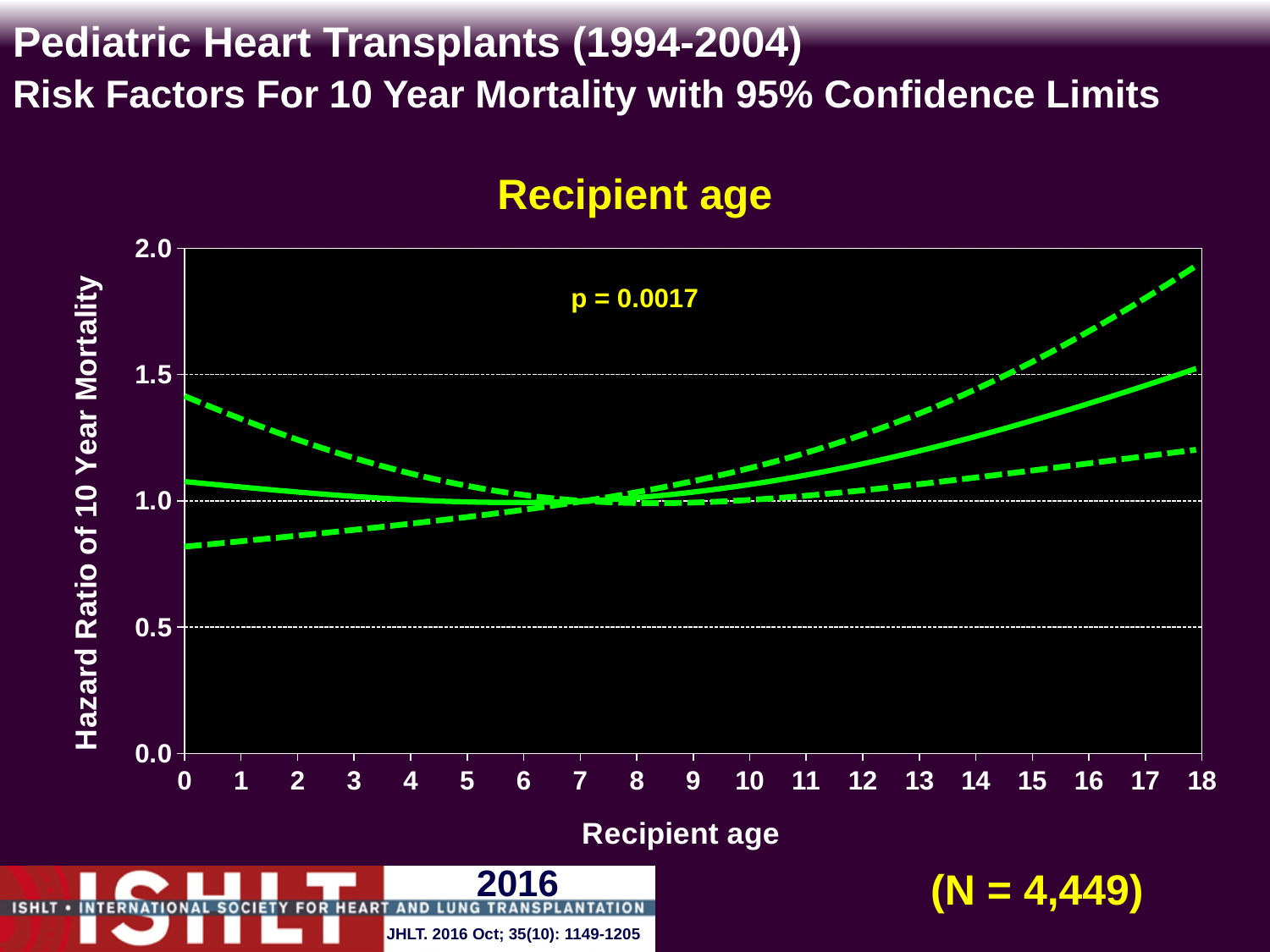
What is the p-value printed on the chart? p = 0.0017 Is the value of the solid hazard ratio line at recipient age 18 greater or less than 1.0? greater What is the title of the chart? Recipient age What is the highest recipient age shown on the x axis? 18 Is the value of the upper dashed confidence limit at recipient age 18 greater or less than 1.5? greater What is the sample size (N) shown on the slide? 4,449 Is the value of the lower dashed confidence limit at recipient age 0 greater or less than 1.0? less How many lines are plotted on the chart? 3 What kind of chart is shown on the slide? line chart Does the solid hazard ratio line rise or fall between recipient age 8 and recipient age 18? rise What is the label of the y axis? Hazard Ratio of 10 Year Mortality